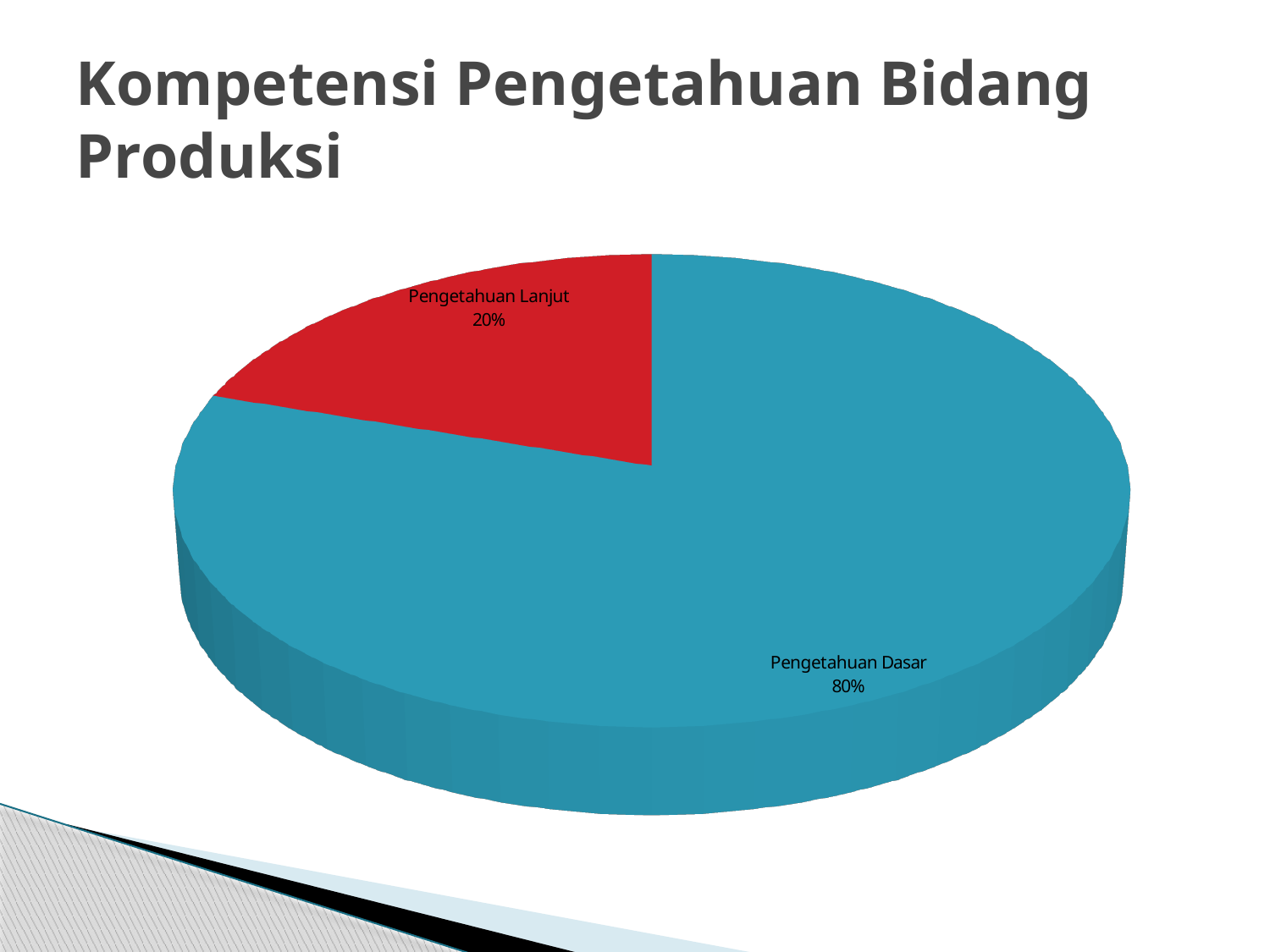
Which slice is the smallest? Pengetahuan Lanjut Which slice is the largest? Pengetahuan Dasar How many slices does the pie chart have? 2 What share of the pie does Pengetahuan Dasar have? 80% What kind of chart is shown on the slide? Pie chart What colour is the Pengetahuan Lanjut slice? Red What share of the pie does Pengetahuan Lanjut have? 20% What is the difference in percentage points between Pengetahuan Dasar and Pengetahuan Lanjut? 60 Which is larger, Pengetahuan Lanjut or Pengetahuan Dasar? Pengetahuan Dasar What is the title of the slide containing the pie chart? Kompetensi Pengetahuan Bidang Produksi